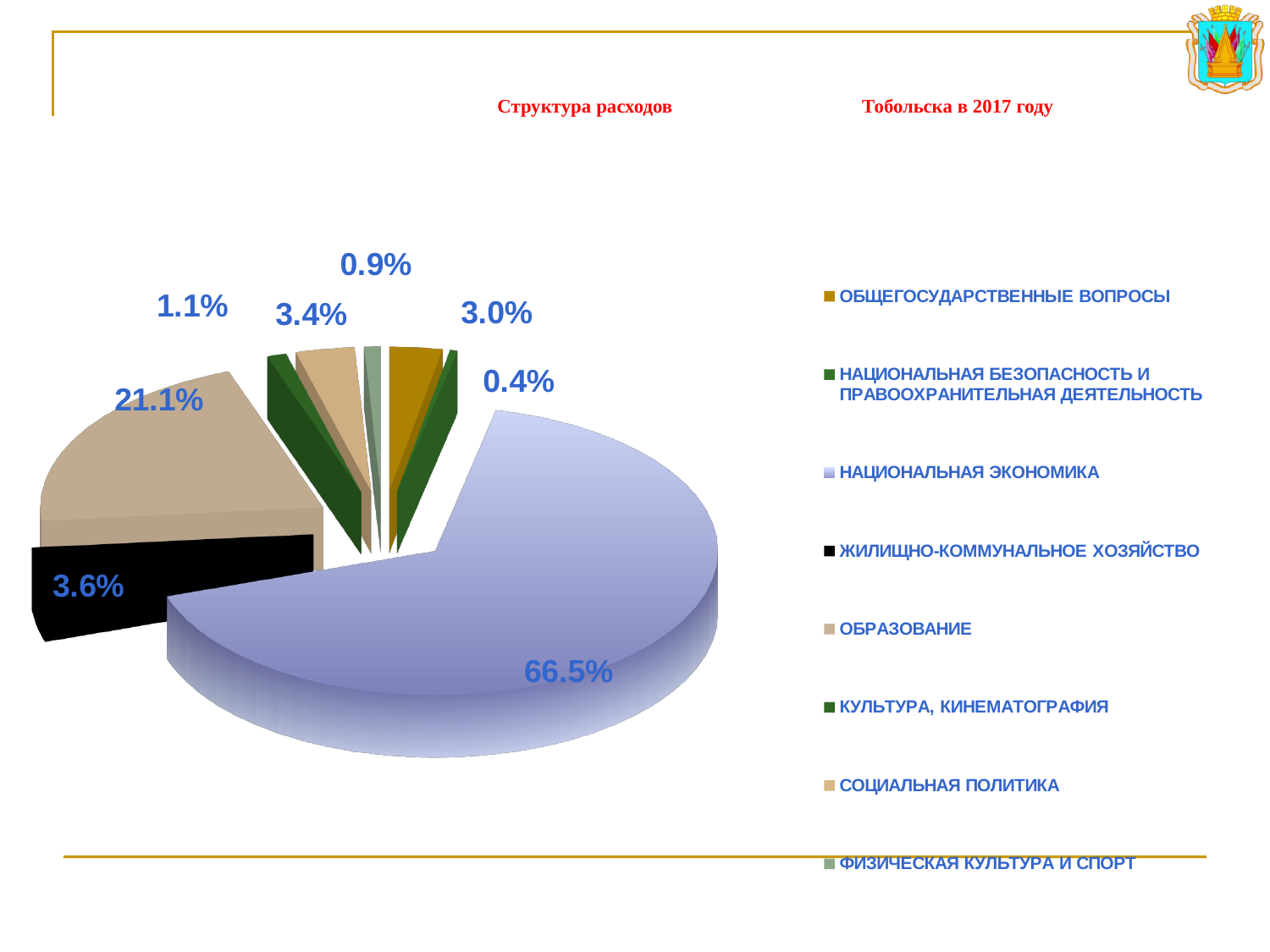
What share is shown for НАЦИОНАЛЬНАЯ ЭКОНОМИКА (the light blue slice)? 66.5% What colour is the slice representing ЖИЛИЩНО-КОММУНАЛЬНОЕ ХОЗЯЙСТВО? black What share is shown for ЖИЛИЩНО-КОММУНАЛЬНОЕ ХОЗЯЙСТВО (the black slice)? 3.6% What kind of chart is shown on the slide? pie chart What is the share of the smallest slice of the pie? 0.4% What is the title of the chart? Структура расходов Тобольска в 2017 году What is the second-largest share shown on the pie chart? 21.1% How many categories does the legend list? 8 Which is larger: the slice labelled 3.6% or the slice labelled 21.1%? 21.1% What is the difference between the largest slice (66.5%) and the second-largest slice (21.1%)? 45.4 percentage points What is the share of the largest slice of the pie? 66.5% How many slices does the pie chart have? 8